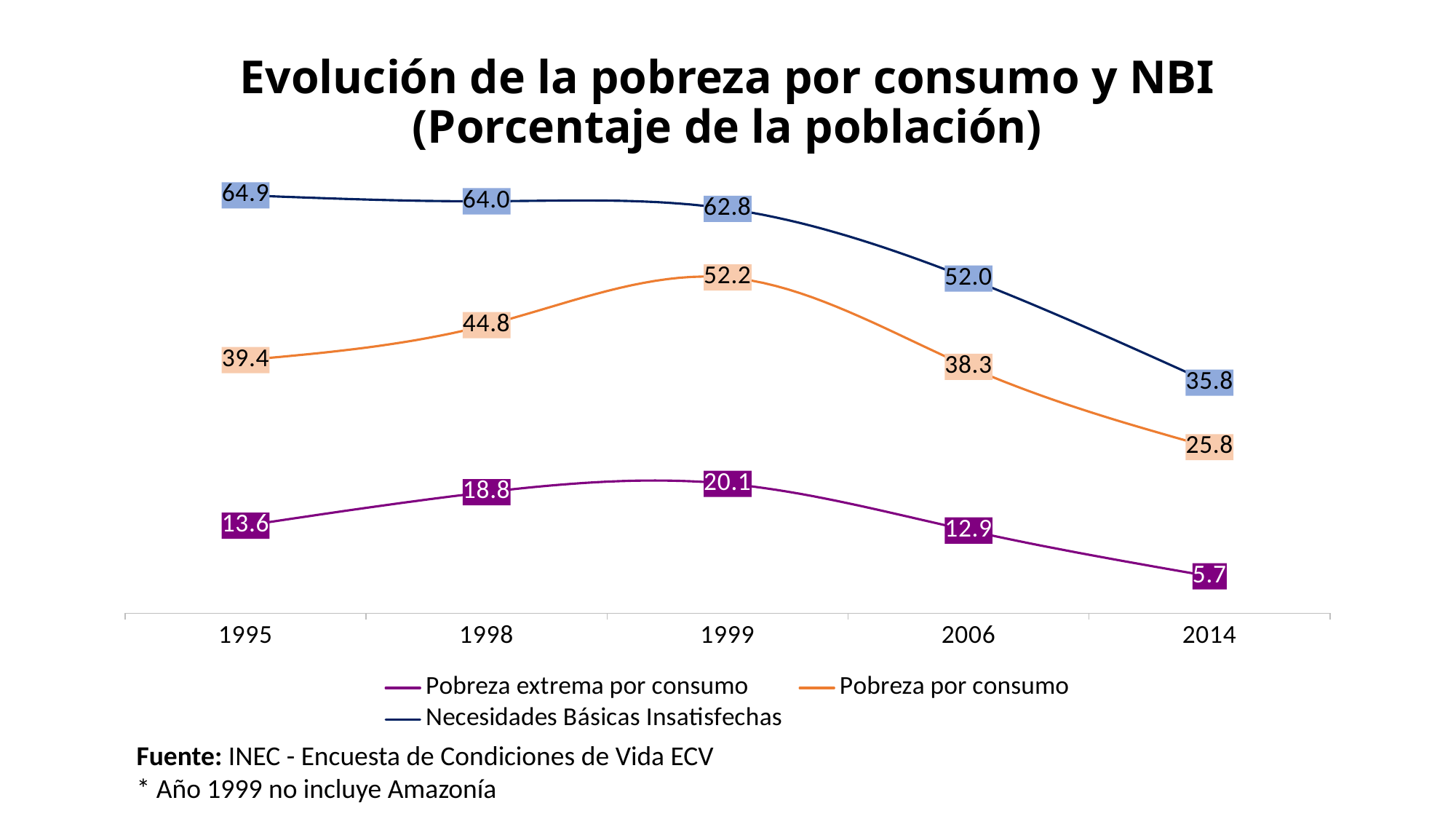
In which year is Pobreza por consumo highest? 1999 Which is larger in 1998: Pobreza por consumo or Pobreza extrema por consumo? Pobreza por consumo What is the value of Necesidades Básicas Insatisfechas in 1995? 64.9 In which year is Pobreza extrema por consumo lowest? 2014 What is the difference between Necesidades Básicas Insatisfechas and Pobreza por consumo in 2014? 10.0 How many series does the legend list? 3 What is the value of Pobreza por consumo in 2006? 38.3 What is the source cited below the chart? INEC - Encuesta de Condiciones de Vida ECV How many years are shown on the x axis? 5 What is the value of Pobreza extrema por consumo in 2014? 5.7 What kind of chart is shown on the slide? Line chart Does Necesidades Básicas Insatisfechas rise or fall from 1995 to 2014? Fall